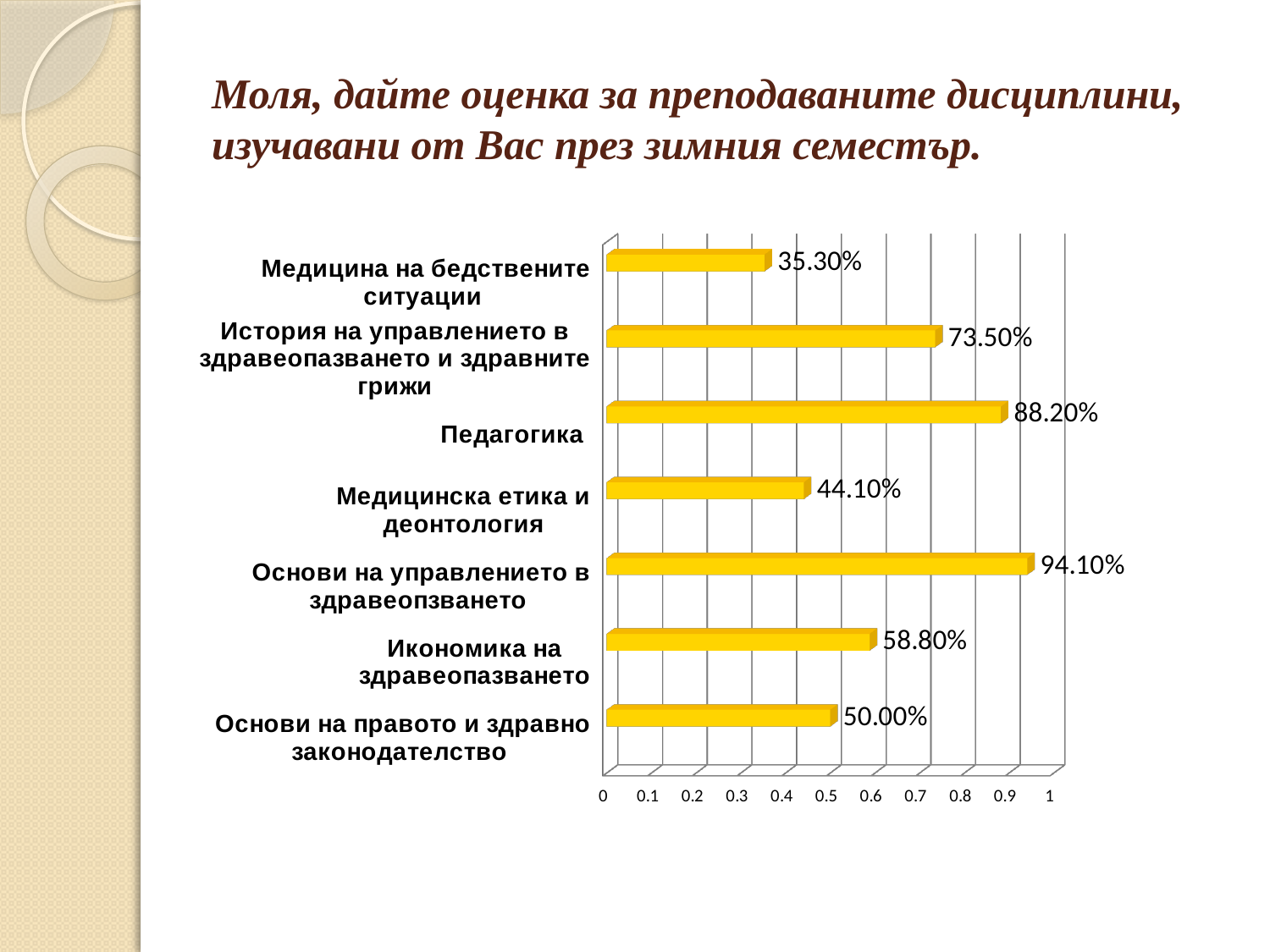
What is the value for Медицина на бедствените ситуации? 35.30% Which is larger: the value for История на управлението в здравеопазването и здравните грижи or the value for Икономика на здравеопазването? История на управлението в здравеопазването и здравните грижи What is the difference between the values for Педагогика and Медицинска етика и деонтология? 44.10% How many categories are shown in the chart? 7 Which category has the highest value? Основи на управлението в здравеопзването What kind of chart is shown on the slide? bar chart What is the value for Педагогика? 88.20% What colour are the bars in the chart? yellow What is the value for Основи на управлението в здравеопзването? 94.10% Which category has the lowest value? Медицина на бедствените ситуации What is the value for Икономика на здравеопазването? 58.80% Is the value for Основи на правото и здравно законодателство greater or less than 0.4? greater